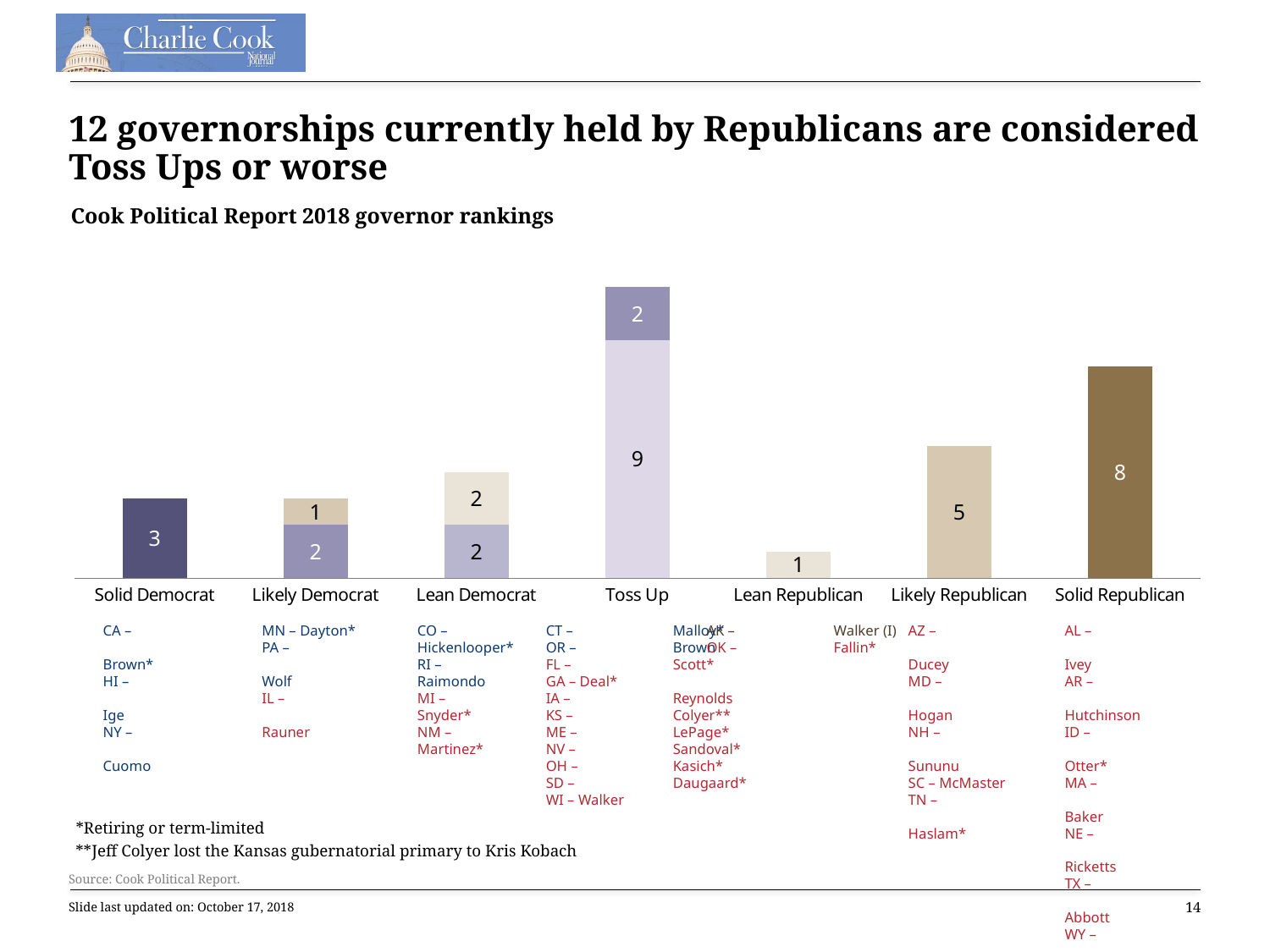
What is the value of the Solid Republican bar? 8 What is the total of the stacked Toss Up bar? 11 What is the value of the larger (lower) segment of the Toss Up bar? 9 How many rating categories are shown along the x axis of the chart? 7 What is the value of the Likely Republican bar? 5 What is the value of the Lean Republican bar? 1 What is the total of the stacked Lean Democrat bar? 4 What kind of chart is shown on the slide? bar chart Which category has the tallest bar? Toss Up Which category has the shortest bar? Lean Republican What is the difference between the Solid Republican and Likely Republican values? 3 What is the total of the stacked Likely Democrat bar? 3